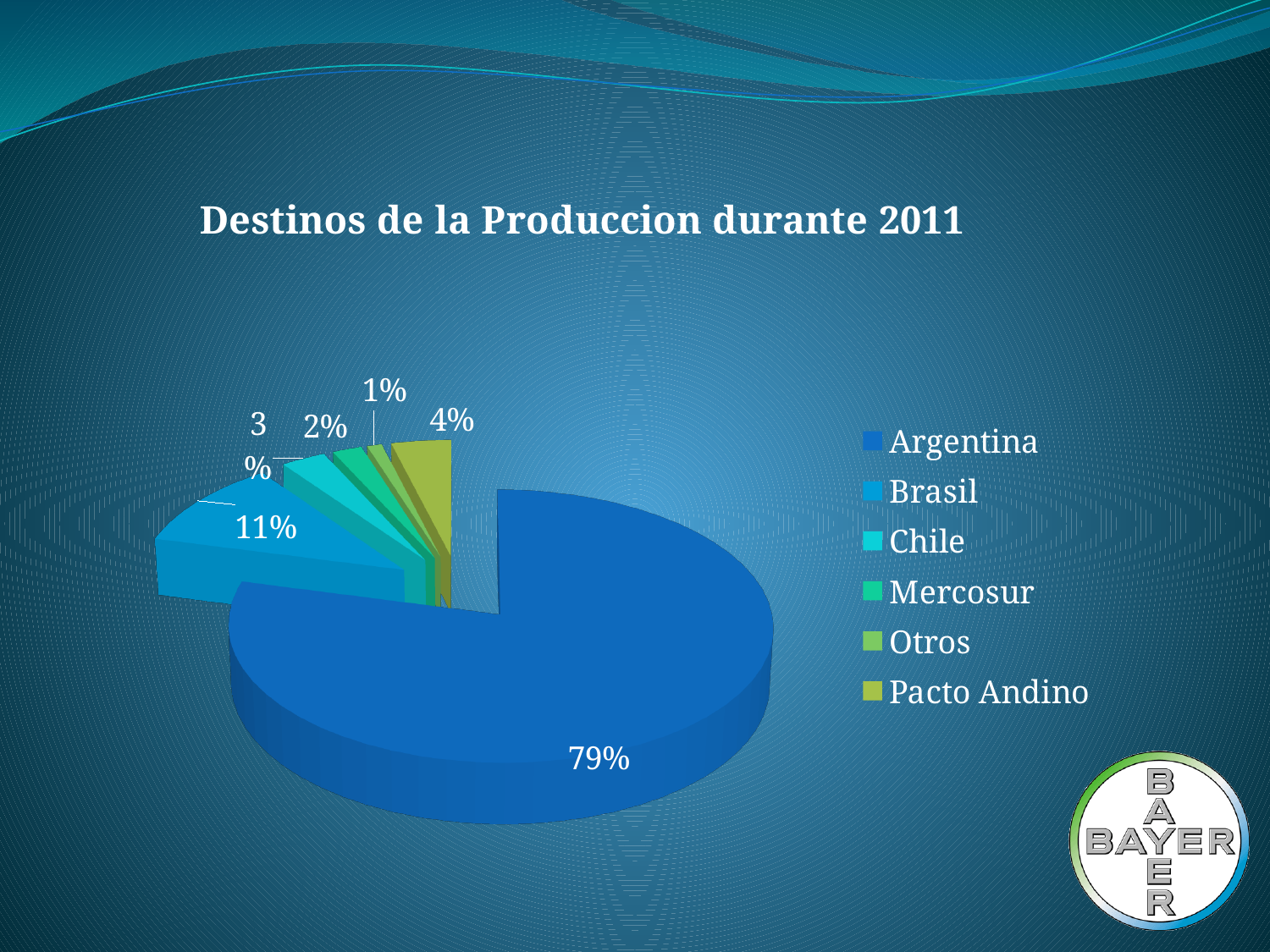
How many categories does the legend list? 6 What share of the pie does Chile have? 3% Which category has the smallest slice of the pie? Otros What is the difference in percentage points between Argentina and Brasil? 68 What kind of chart is shown on the slide? pie chart What share of the pie does Otros have? 1% Which has a larger share, Pacto Andino or Mercosur? Pacto Andino Which category has the largest slice of the pie? Argentina What is the title of the chart? Destinos de la Produccion durante 2011 What share of the pie does Brasil have? 11% What share of the pie does Pacto Andino have? 4% What share of the pie does Argentina have? 79%